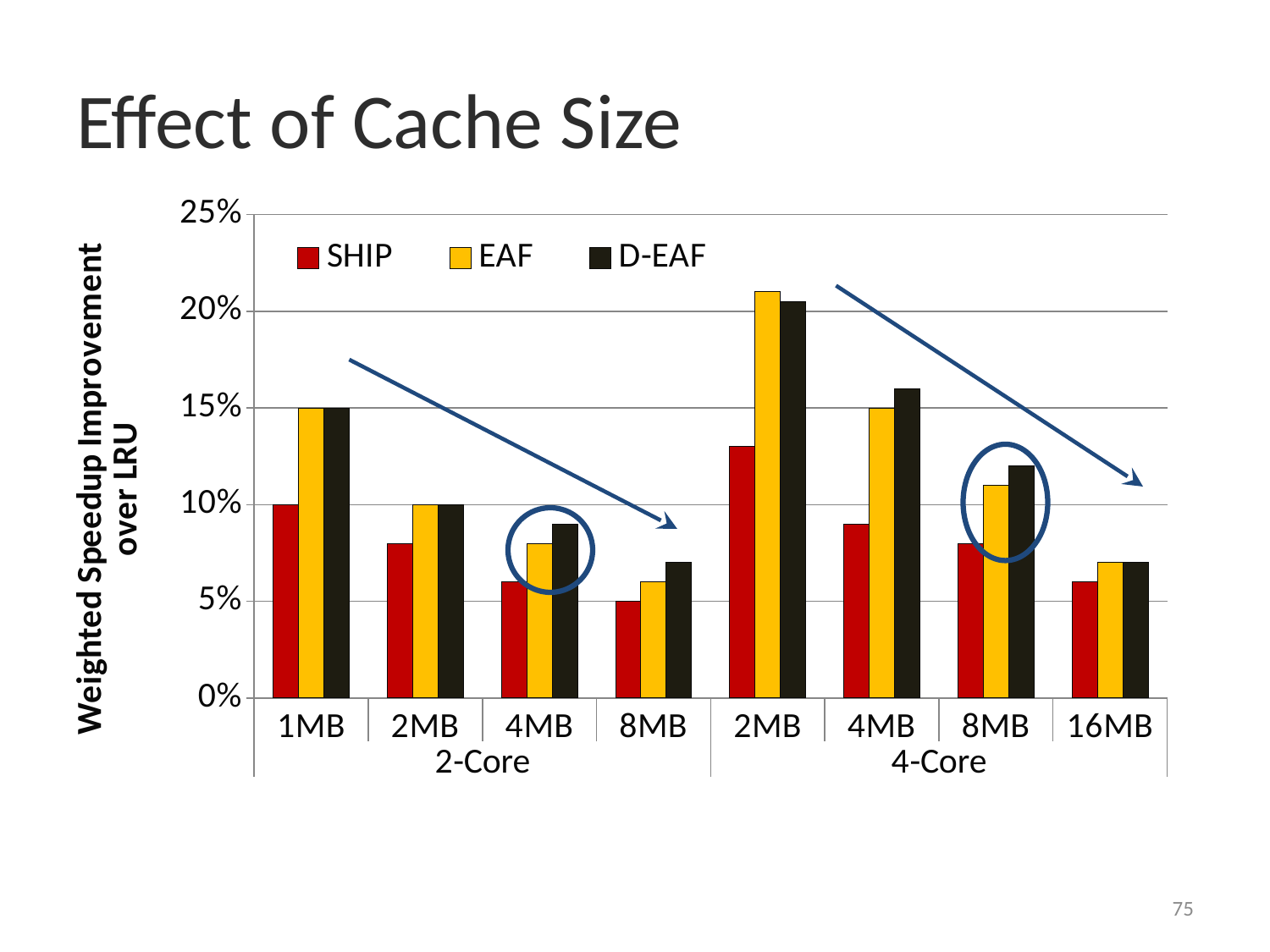
Is the SHIP value for 16MB in the 4-Core group greater or less than 10%? less What is the SHIP value for 1MB in the 2-Core group? 10% How many series does the legend list? 3 What is the SHIP value for 8MB in the 2-Core group? 5% What is the EAF value for 1MB in the 2-Core group? 15% What are the three series named in the legend? SHIP, EAF, D-EAF What is the title of the slide's chart? Effect of Cache Size How many cache-size categories are shown along the x axis in total? 8 Is the EAF value for 2MB in the 4-Core group greater or less than 20%? greater Which cache size in the 4-Core group has the highest EAF value? 2MB What kind of chart is shown on the slide? bar chart Within the 2-Core group, do the SHIP values rise or fall as cache size increases from 1MB to 8MB? fall